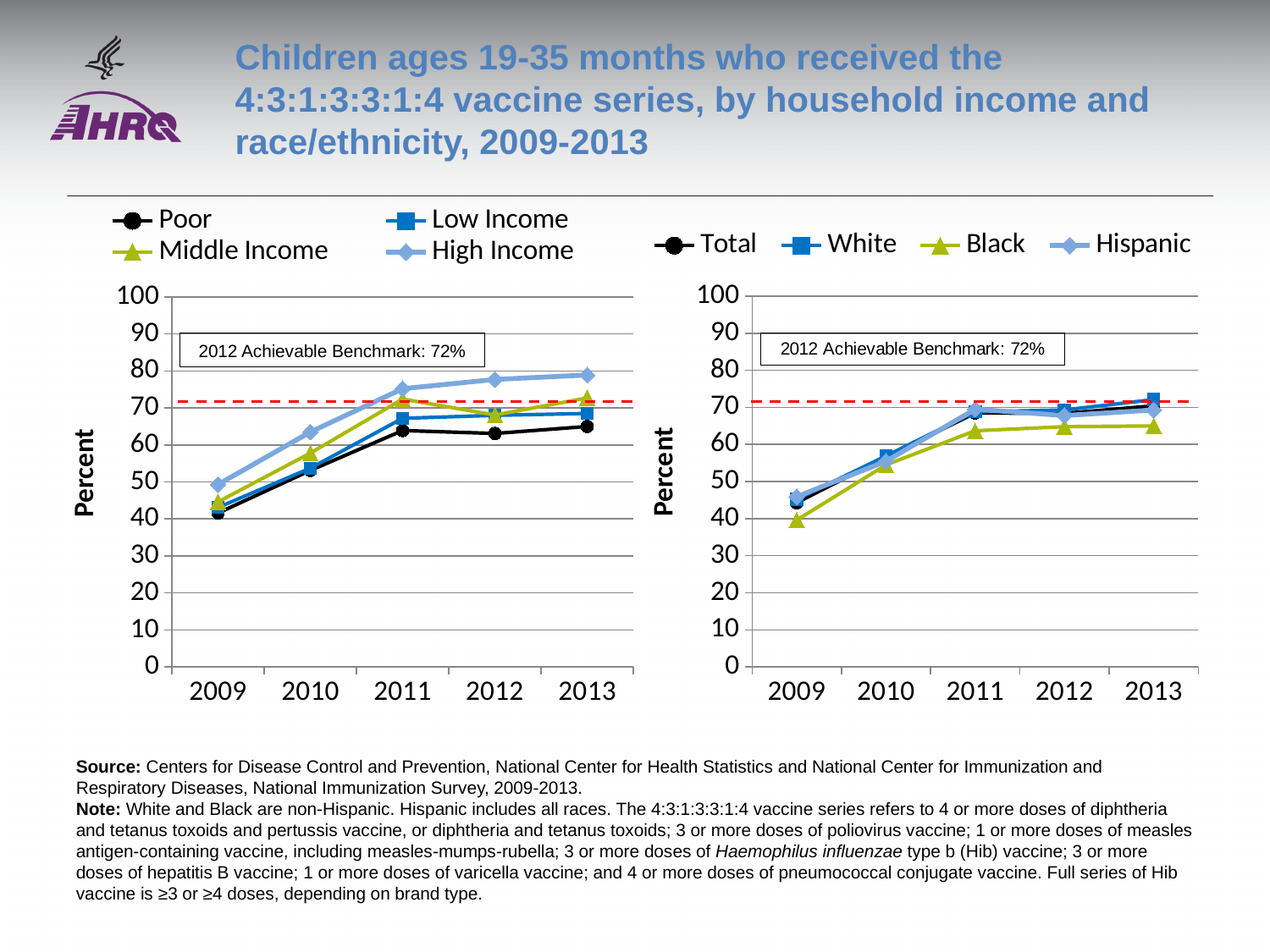
In the right chart (by race/ethnicity), is the value for Black in 2013 greater or less than 70? less What kind of chart is the left chart (by household income)? line chart How many years are shown on the x axis of the right chart (by race/ethnicity)? 5 How many series does the legend of the left chart (by household income) list? 4 In the left chart (by household income), is the value for High Income in 2013 greater or less than 70? greater In the right chart (by race/ethnicity), which group has the lowest value in 2009? Black In the right chart (by race/ethnicity), does the Total line rise or fall from 2009 to 2011? rise In the left chart (by household income), which income group has the highest value in 2013? High Income In the left chart (by household income), is the value for Poor in 2009 greater or less than 50? less In the left chart (by household income), which income group has the lowest value in 2009? Poor In the right chart (by race/ethnicity), which is larger in 2013, the value for White or the value for Black? White What is the 2012 Achievable Benchmark shown on the charts? 72%